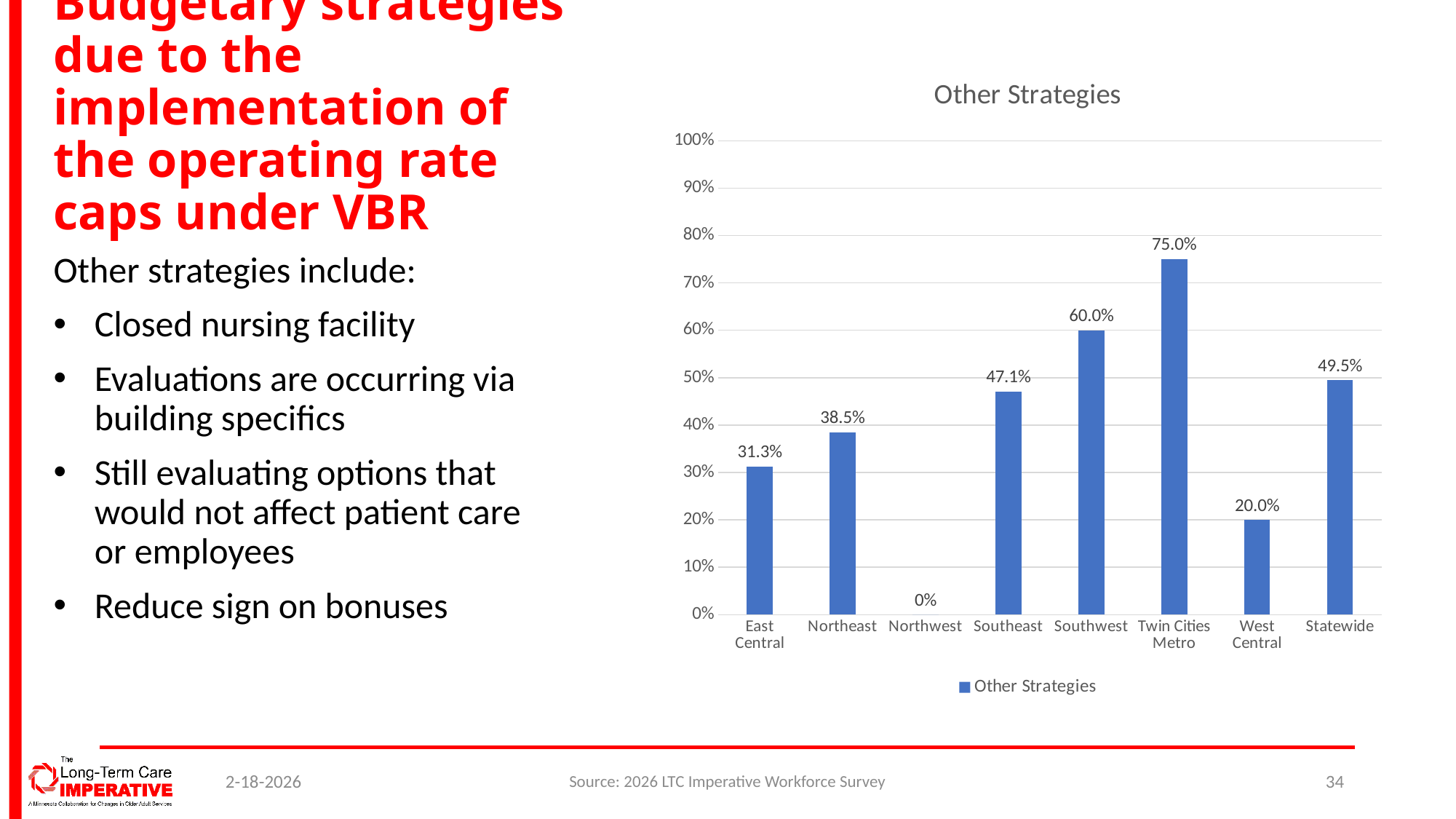
Which is larger, the value for Northeast or the value for Southeast? Southeast What is the value for Statewide? 49.5% Which region has the lowest value? Northwest What is the value for East Central? 31.3% How many series does the legend list? 1 Which region has the highest value? Twin Cities Metro What is the difference between the values for Southwest and West Central? 40.0% What is the title of the chart? Other Strategies What kind of chart is shown? bar chart What is the value for Twin Cities Metro? 75.0% Is the value for Southwest greater or less than 50%? greater How many categories are shown on the x axis? 8